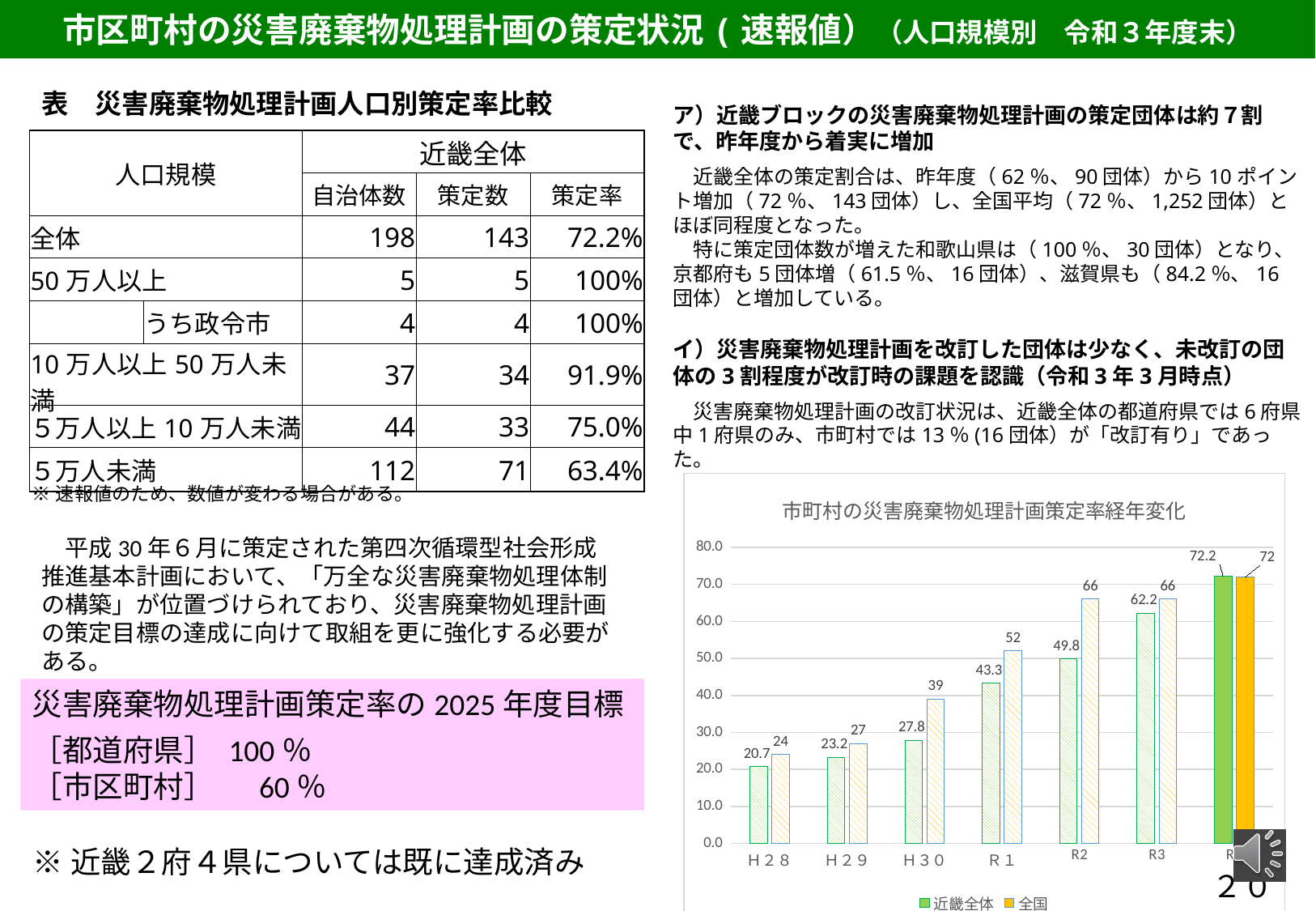
How many series does the legend of the chart 市町村の災害廃棄物処理計画策定率経年変化 list? 2 In the chart 市町村の災害廃棄物処理計画策定率経年変化, what is the value for 全国 in R1? 52 In the chart 市町村の災害廃棄物処理計画策定率経年変化, what is the value for 近畿全体 in R3? 62.2 In the chart 市町村の災害廃棄物処理計画策定率経年変化, is the value for 近畿全体 in R1 greater or less than 40? greater How many categories are shown on the x axis of the chart 市町村の災害廃棄物処理計画策定率経年変化? 7 In the chart 市町村の災害廃棄物処理計画策定率経年変化, what is the value for 近畿全体 in H30? 27.8 In the chart 市町村の災害廃棄物処理計画策定率経年変化, do the 近畿全体 values rise or fall from H28 to the last year? rise In the chart 市町村の災害廃棄物処理計画策定率経年変化, what is the value for 全国 in H28? 24 What kind of chart is 市町村の災害廃棄物処理計画策定率経年変化? bar chart In the chart 市町村の災害廃棄物処理計画策定率経年変化, in which year is the 近畿全体 value lowest? H28 In the chart 市町村の災害廃棄物処理計画策定率経年変化, what is the difference between the 全国 and 近畿全体 values in R2? 16.2 In the chart 市町村の災害廃棄物処理計画策定率経年変化, which series has the larger value in H29, 近畿全体 or 全国? 全国